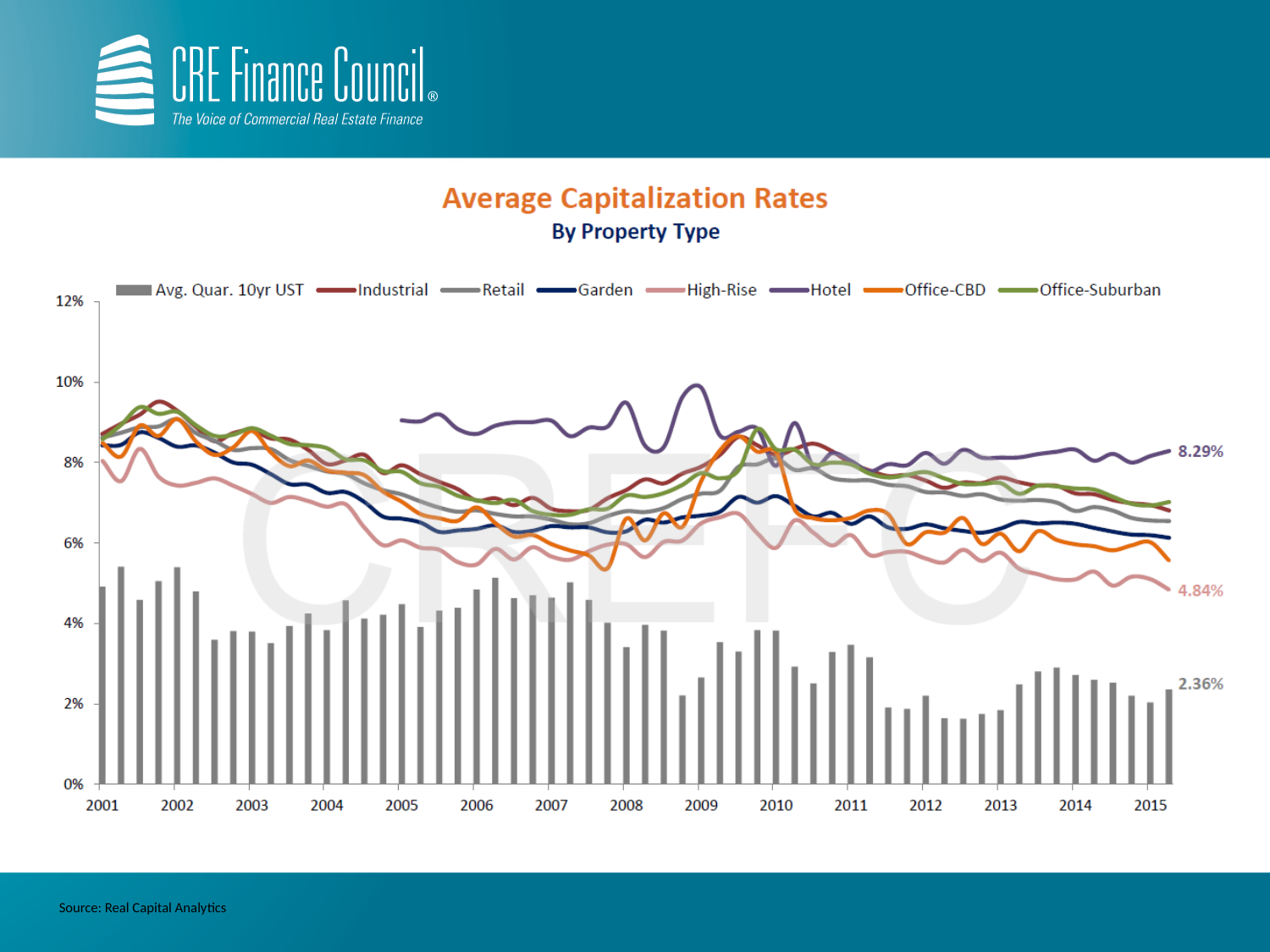
Which property type line has the highest capitalization rate at the end of the series in 2015? Hotel Which series is plotted as bars rather than a line? Avg. Quar. 10yr UST What is the title of the chart? Average Capitalization Rates Is the peak of the Hotel line around 2009 greater or less than 9%? greater What is the difference between the labelled Hotel value (8.29%) and the labelled High-Rise value (4.84%) at the end of the series? 3.45 percentage points At the end of the series in 2015, which is larger: the Hotel value or the High-Rise value? Hotel What is the labelled value of the Avg. Quar. 10yr UST bar at the end of the series in 2015? 2.36% Does the High-Rise line generally rise or fall from 2001 to 2015? fall What is the labelled value of the Hotel line at the end of the series in 2015? 8.29% What is the labelled value of the High-Rise line at the end of the series in 2015? 4.84% How many series does the legend list? 8 Which property type line has the lowest capitalization rate at the end of the series in 2015? High-Rise